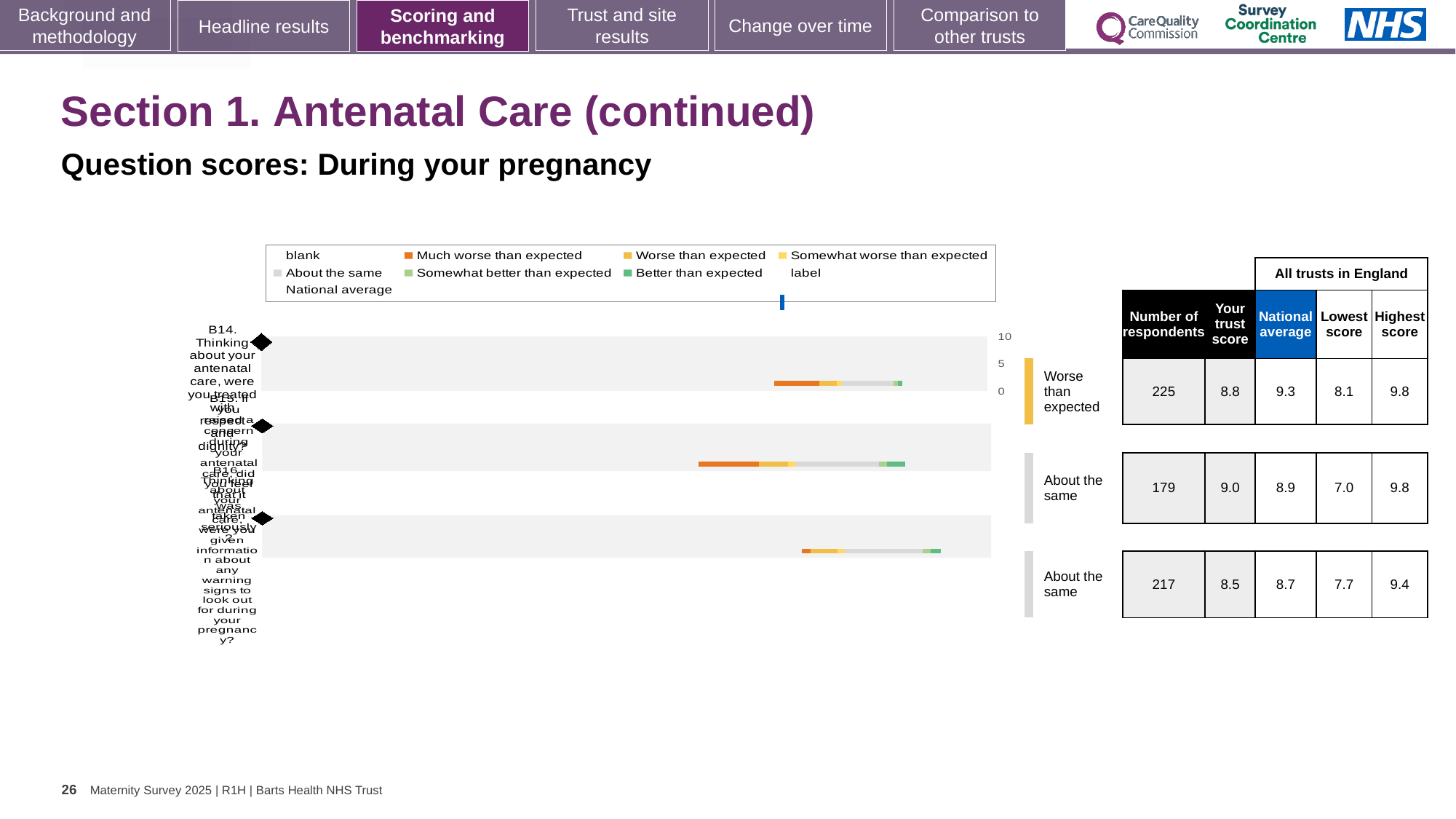
For the top row (B14), what is the difference between the national average (9.3) and the trust score (8.8)? 0.5 In the table next to the chart, what is the number of respondents for the top row (B14, treated with respect and dignity)? 225 In the table next to the chart, what is the highest score for the third (bottom) row? 9.4 Which row has the highest number of respondents in the table? the top row (B14), 225 In the chart legend, what colour represents 'Much worse than expected'? orange In the table next to the chart, what is the trust score for the top row (B14)? 8.8 How many question rows (bars) are plotted in the chart? 3 For the top row (B14), which is larger: the trust score or the national average? national average In the table next to the chart, what is the national average for the second row? 8.9 What kind of chart is shown on the slide? bar chart What is the highest tick value shown on the chart's score axis? 10 What benchmark category label is shown for the top row (B14)? Worse than expected